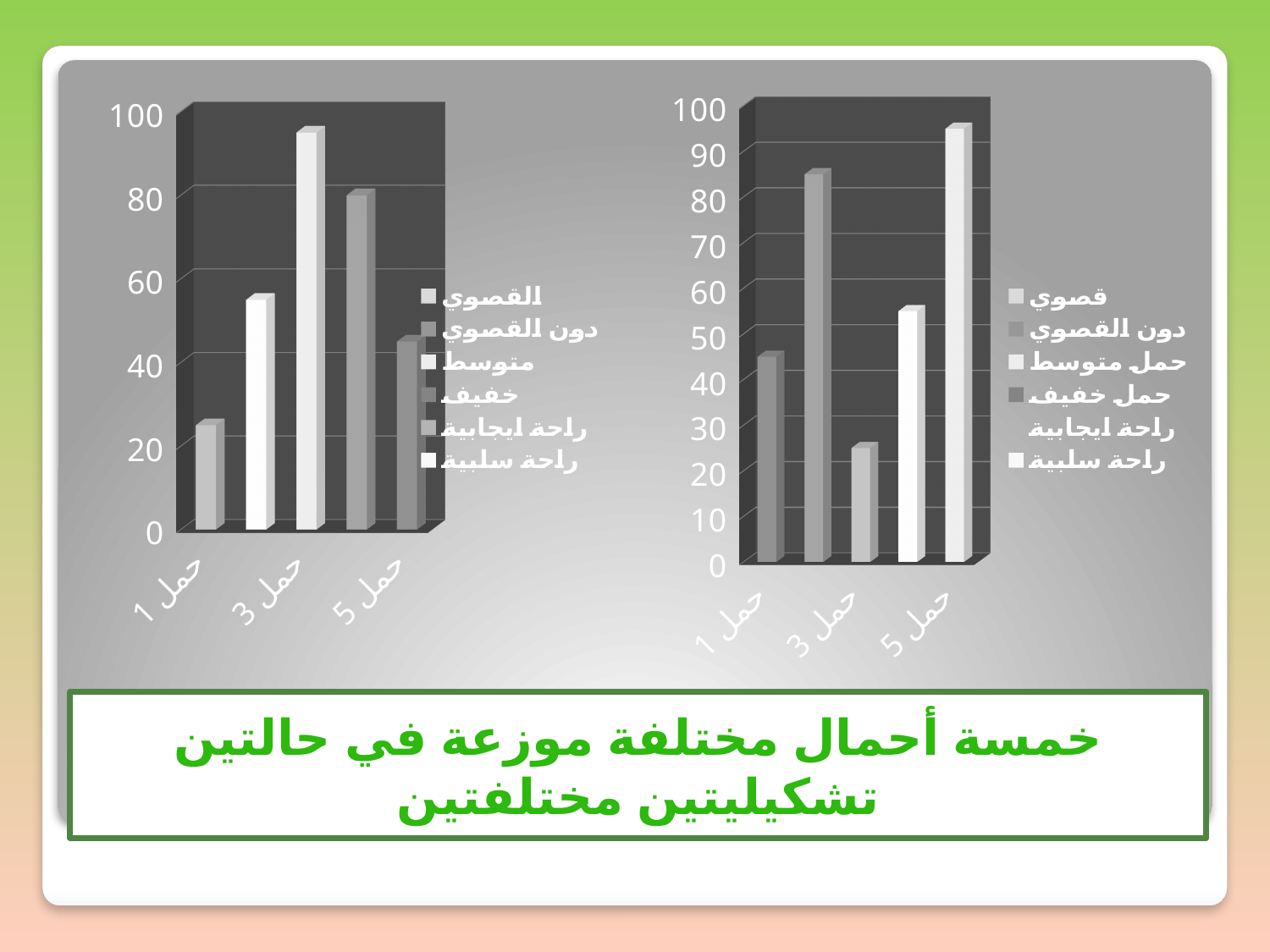
How many bars are plotted in the chart on the right side of the slide? 5 How many series does the legend of the left chart list? 6 In the right chart, which labelled category has the shortest bar? حمل 3 In the left chart, which labelled category has the shortest bar? حمل 1 What is the first legend entry of the right chart? قصوي In the left chart, which labelled category has the tallest bar? حمل 3 In the right chart, which labelled category has the tallest bar? حمل 5 In the right chart, is the value for حمل 3 greater or less than 30? less In the left chart, is the value for حمل 3 greater or less than 80? greater What kind of chart is the chart on the left side of the slide? bar chart In the right chart, which is larger, the value for حمل 1 or the value for حمل 3? حمل 1 In the left chart, is the value for حمل 1 greater or less than 40? less